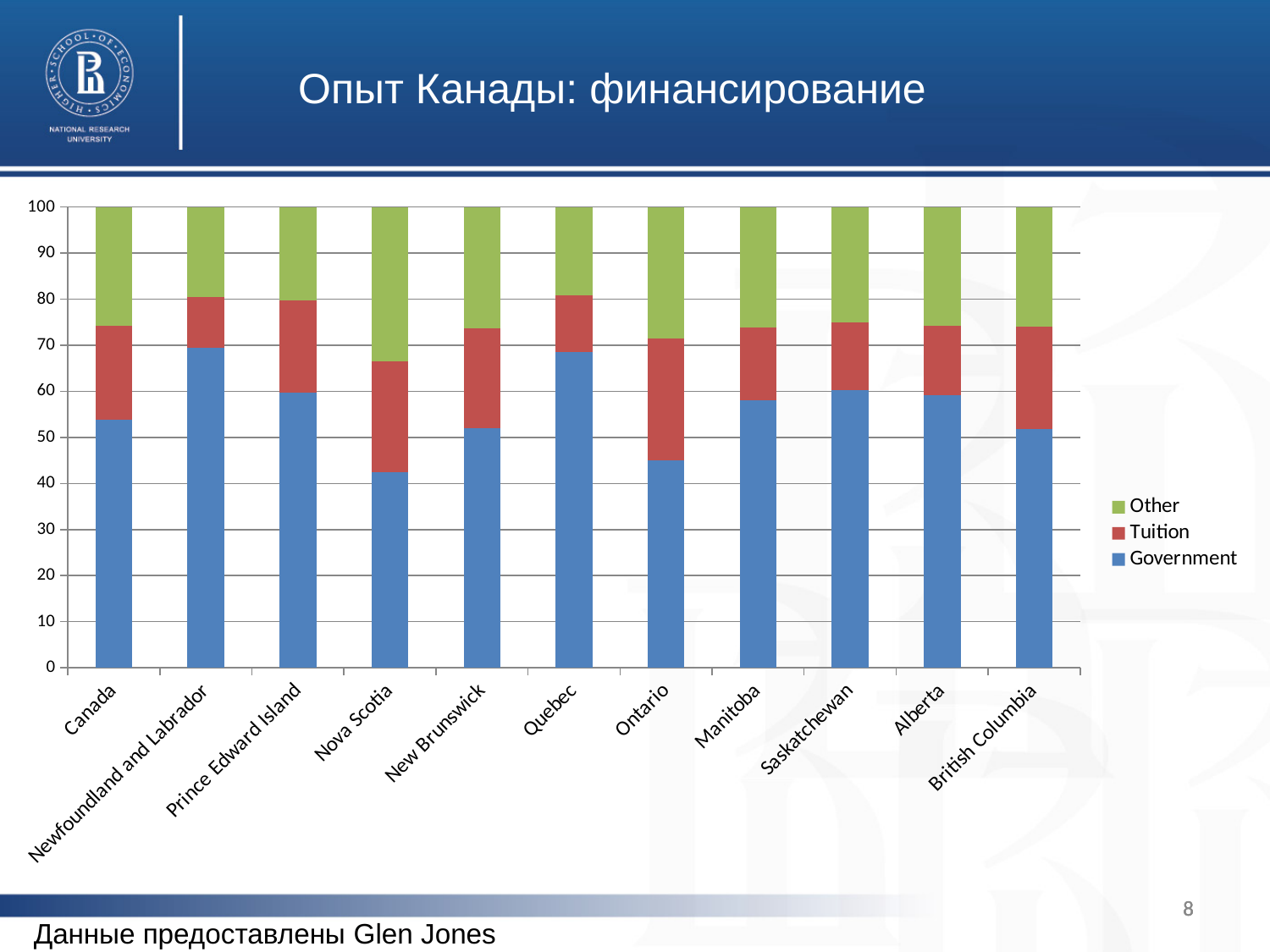
Which series are listed in the legend? Other, Tuition, Government How many categories (provinces/regions) are shown on the x axis? 11 Is the Government value for Newfoundland and Labrador greater or less than 60? greater Is the Government value for Canada greater or less than 50? greater What kind of chart is shown on the slide? Stacked bar chart What is the total height of the stacked bar for Canada? 100 How many series does the legend list? 3 Is the Government value for Ontario greater or less than 50? less What colour represents the Government series? Blue Which has the larger Government value, Ontario or Manitoba? Manitoba Which has the larger Government value, Newfoundland and Labrador or Nova Scotia? Newfoundland and Labrador